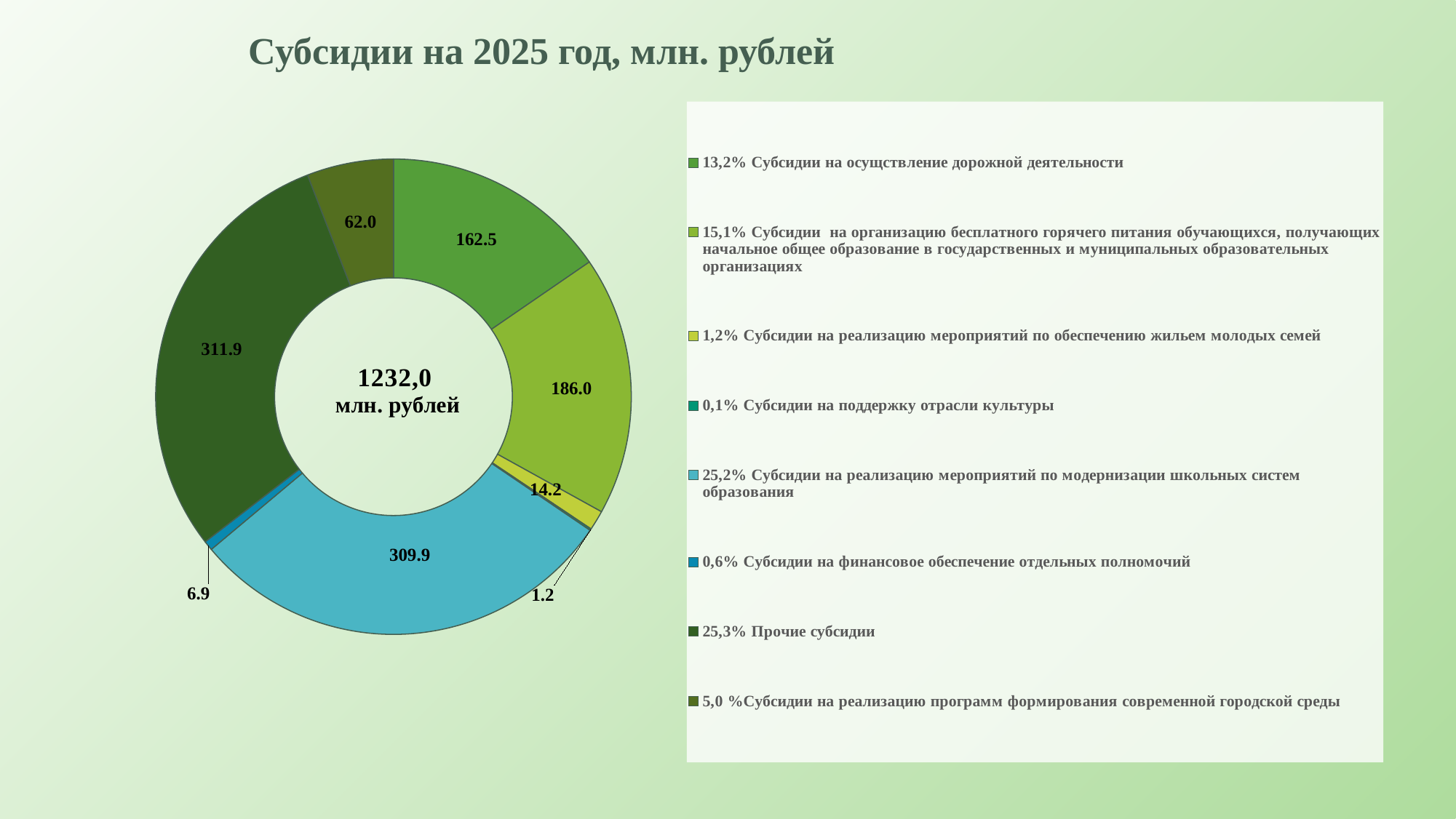
Which category has the smallest value? Субсидии на поддержку отрасли культуры (1.2) What is the title of the chart? Субсидии на 2025 год, млн. рублей Which category has the largest value? Прочие субсидии (311.9) What total is shown in the centre of the doughnut chart? 1232,0 млн. рублей What is the value for Субсидии на реализацию мероприятий по модернизации школьных систем образования? 309.9 What type of chart is shown on the slide? Doughnut (pie) chart Which is larger: the value for Субсидии на реализацию мероприятий по обеспечению жильем молодых семей or Субсидии на финансовое обеспечение отдельных полномочий? Субсидии на реализацию мероприятий по обеспечению жильем молодых семей (14.2) What is the value for Субсидии на реализацию программ формирования современной городской среды? 62.0 What share of the total do Прочие субсидии represent according to the legend? 25,3% How many categories does the chart show? 8 What is the difference between the value for Субсидии на организацию бесплатного горячего питания (186.0) and Субсидии на осуществление дорожной деятельности (162.5)? 23.5 What is the value for Субсидии на осуществление дорожной деятельности? 162.5